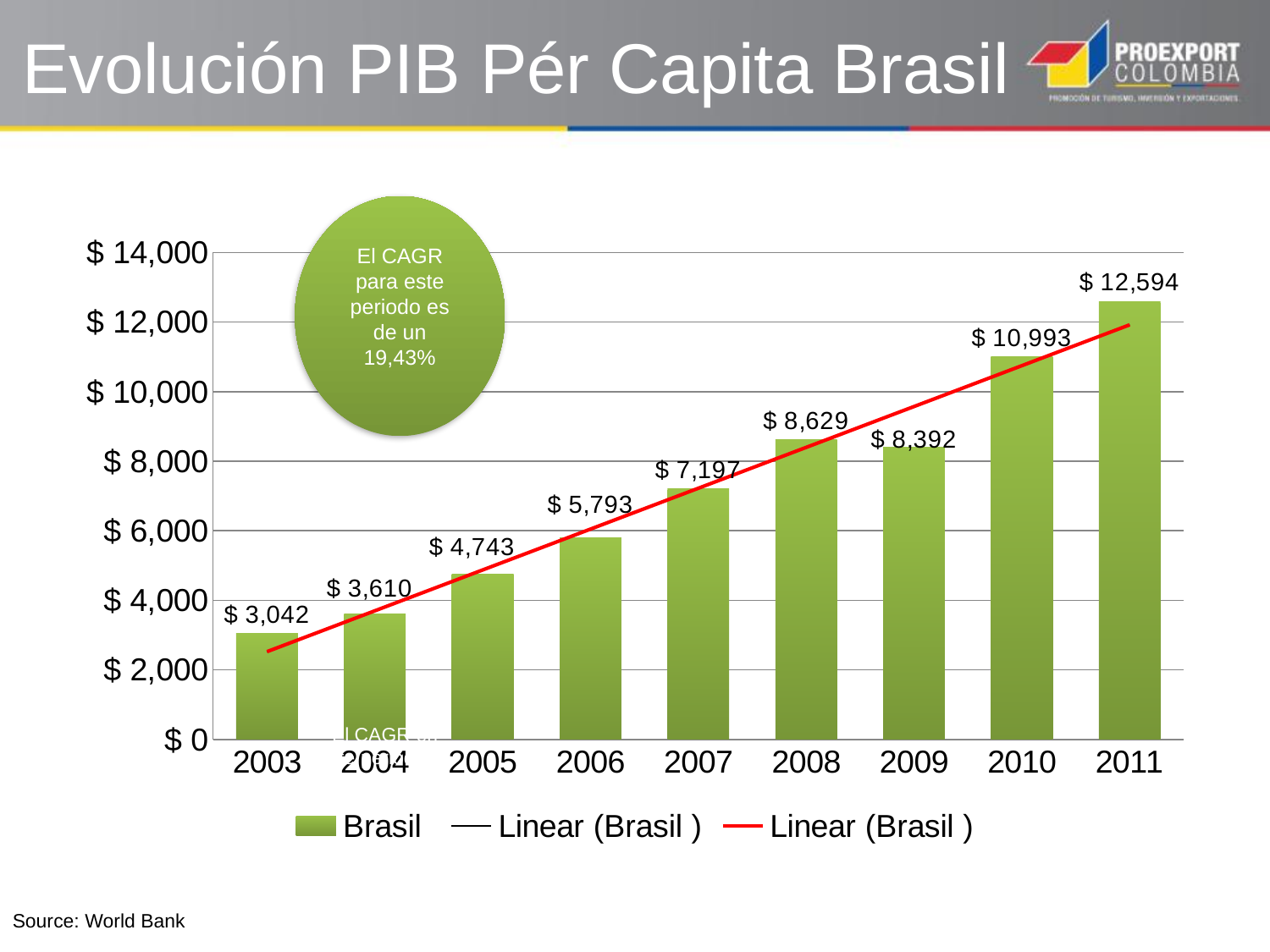
Is the value for 2006 greater or less than $ 6,000? less What is the difference between the values for 2011 and 2010? $ 1,601 What CAGR does the green circle on the chart state for the period? 19,43% What is the value for 2003? $ 3,042 Which is larger, the value for 2008 or the value for 2009? 2008 Which year has the lowest value? 2003 What is the value for 2007? $ 7,197 What kind of chart is shown on the slide? bar chart How many entries does the legend list? 3 What is the value for 2010? $ 10,993 How many years are shown on the x axis? 9 Which year has the highest value? 2011